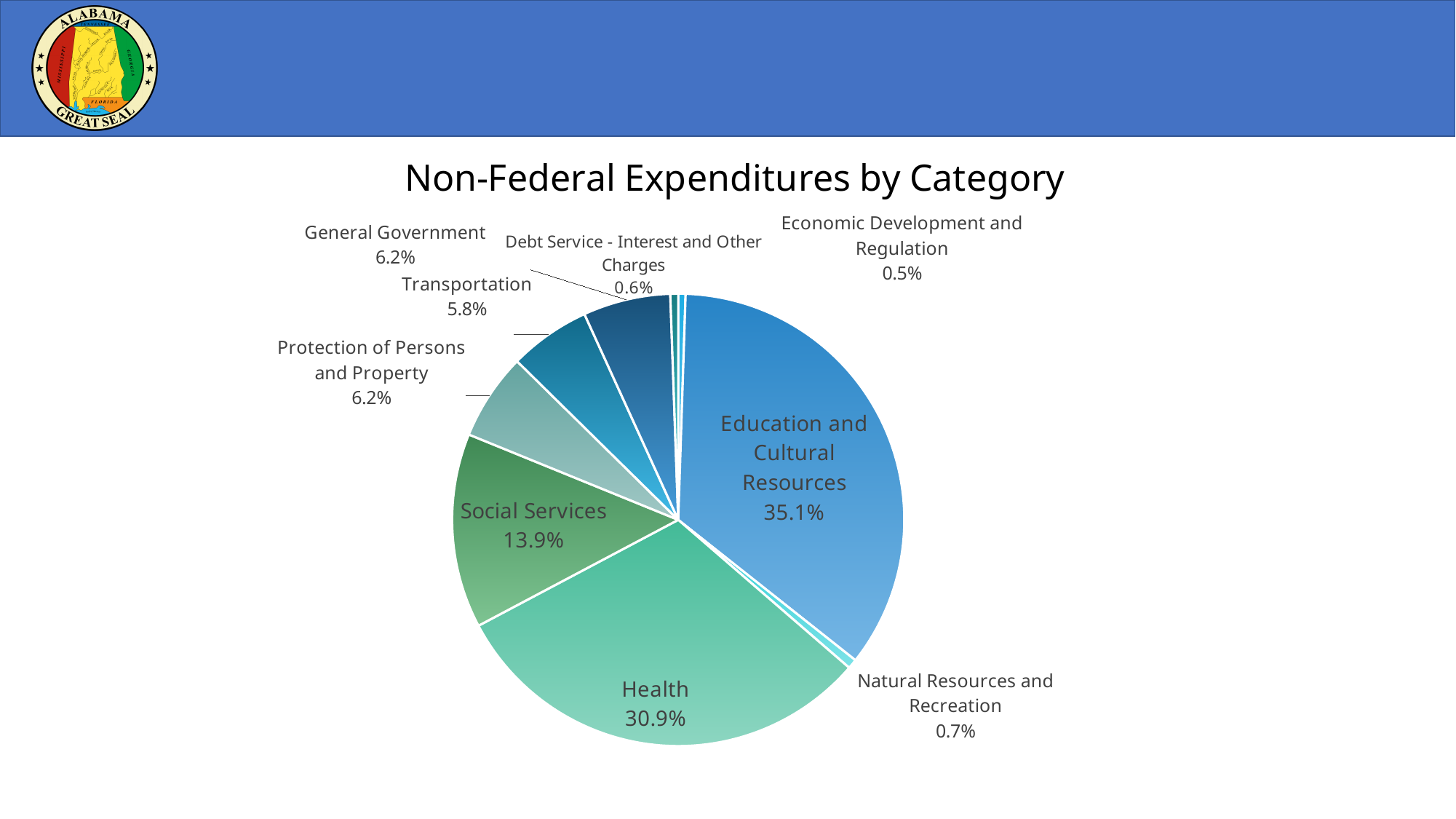
Which category has the largest share of non-federal expenditures? Education and Cultural Resources What percentage is shown for Social Services? 13.9% What type of chart is shown on the slide? pie chart What is the difference in percentage points between Education and Cultural Resources and Health? 4.2 What percentage is shown for Natural Resources and Recreation? 0.7% What percentage is shown for Transportation? 5.8% Which category has the smallest share of non-federal expenditures? Economic Development and Regulation How many categories are shown in the pie chart? 9 What share of non-federal expenditures goes to Health? 30.9% Which is larger, the share for Transportation or the share for General Government? General Government What is the combined share of Social Services and Health? 44.8% What is the title of the chart? Non-Federal Expenditures by Category